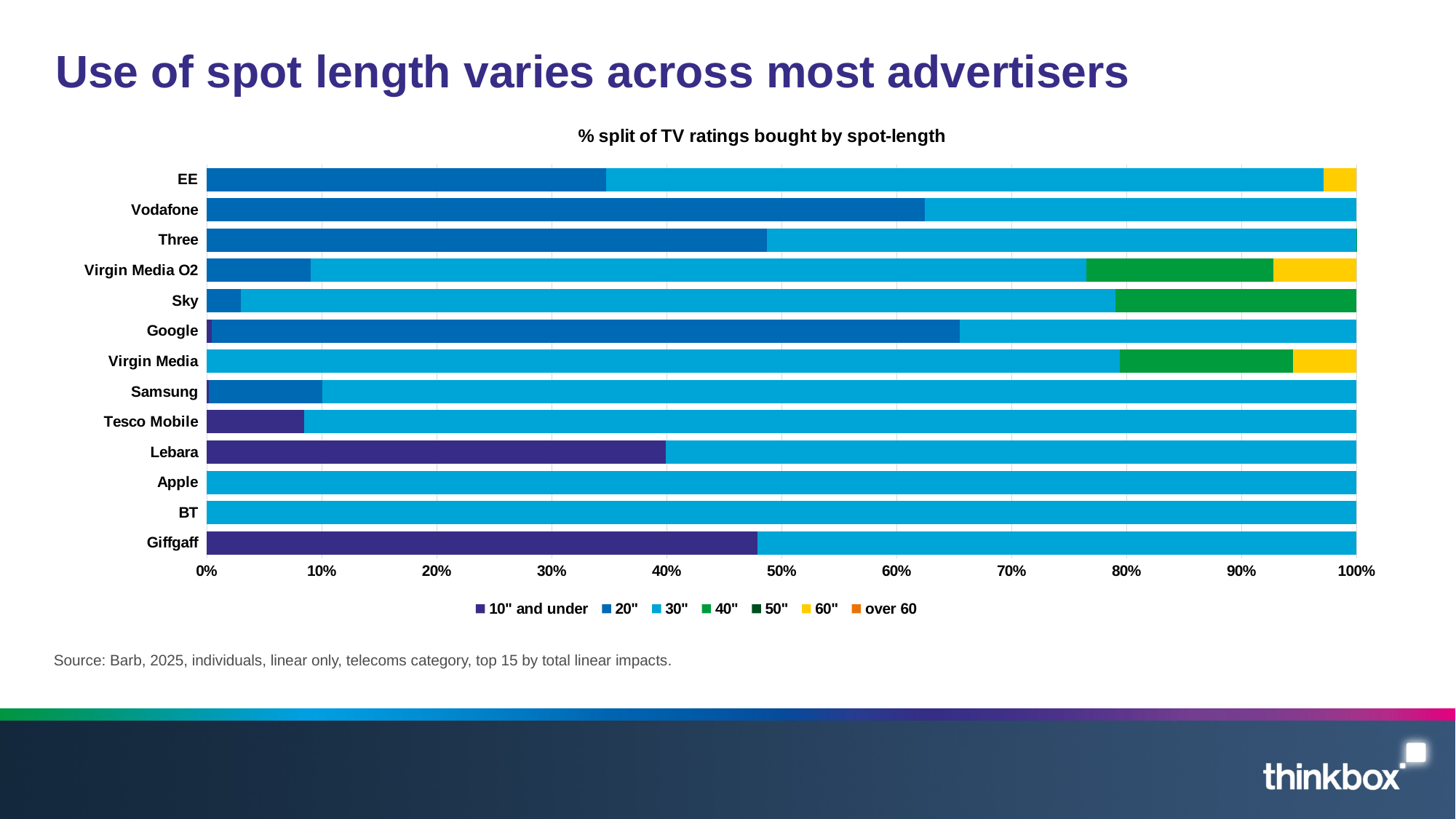
What is the title of the chart? % split of TV ratings bought by spot-length Is the 10" and under share for Giffgaff greater or less than 40%? greater How many spot-length series does the legend list? 7 How many advertisers are listed on the chart? 13 Is the 20" share for Vodafone greater or less than 60%? greater What kind of chart is shown on the slide? Stacked bar chart Which has a larger 10" and under share, Lebara or Tesco Mobile? Lebara Which has a larger 20" share, Vodafone or EE? Vodafone Is the 20" share for Virgin Media O2 greater or less than 10%? less Which advertiser has the largest share of 10" and under spots? Giffgaff Which advertisers' bars are made up entirely of 30" spots? Apple and BT